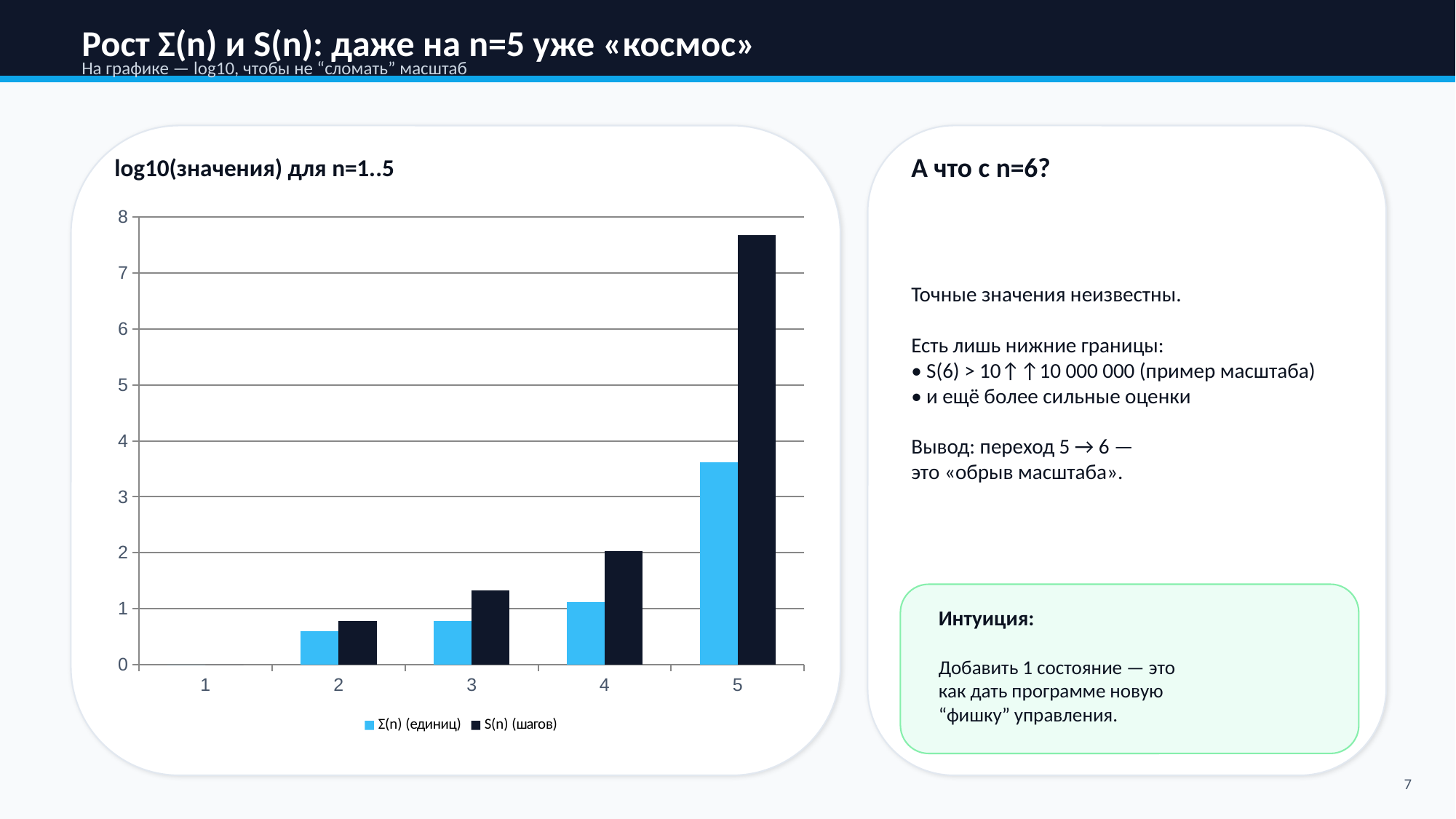
For which value of n is the S(n) (шагов) bar the highest? 5 How many series does the chart legend list? 2 Is the value of Σ(n) (единиц) at n=2 greater or less than 1? less Is the value of Σ(n) (единиц) at n=5 greater or less than 3? greater How many values of n are shown on the x axis of the chart? 5 At n=5, which is larger: Σ(n) (единиц) or S(n) (шагов)? S(n) (шагов) Is the value of S(n) (шагов) at n=5 greater or less than 7? greater For which value of n is the Σ(n) (единиц) bar the highest? 5 What is the title of the chart? log10(значения) для n=1..5 What kind of chart is shown on the slide? bar chart Do the S(n) (шагов) values rise or fall as n increases from 2 to 5? rise Which series is drawn in light blue in the chart? Σ(n) (единиц)